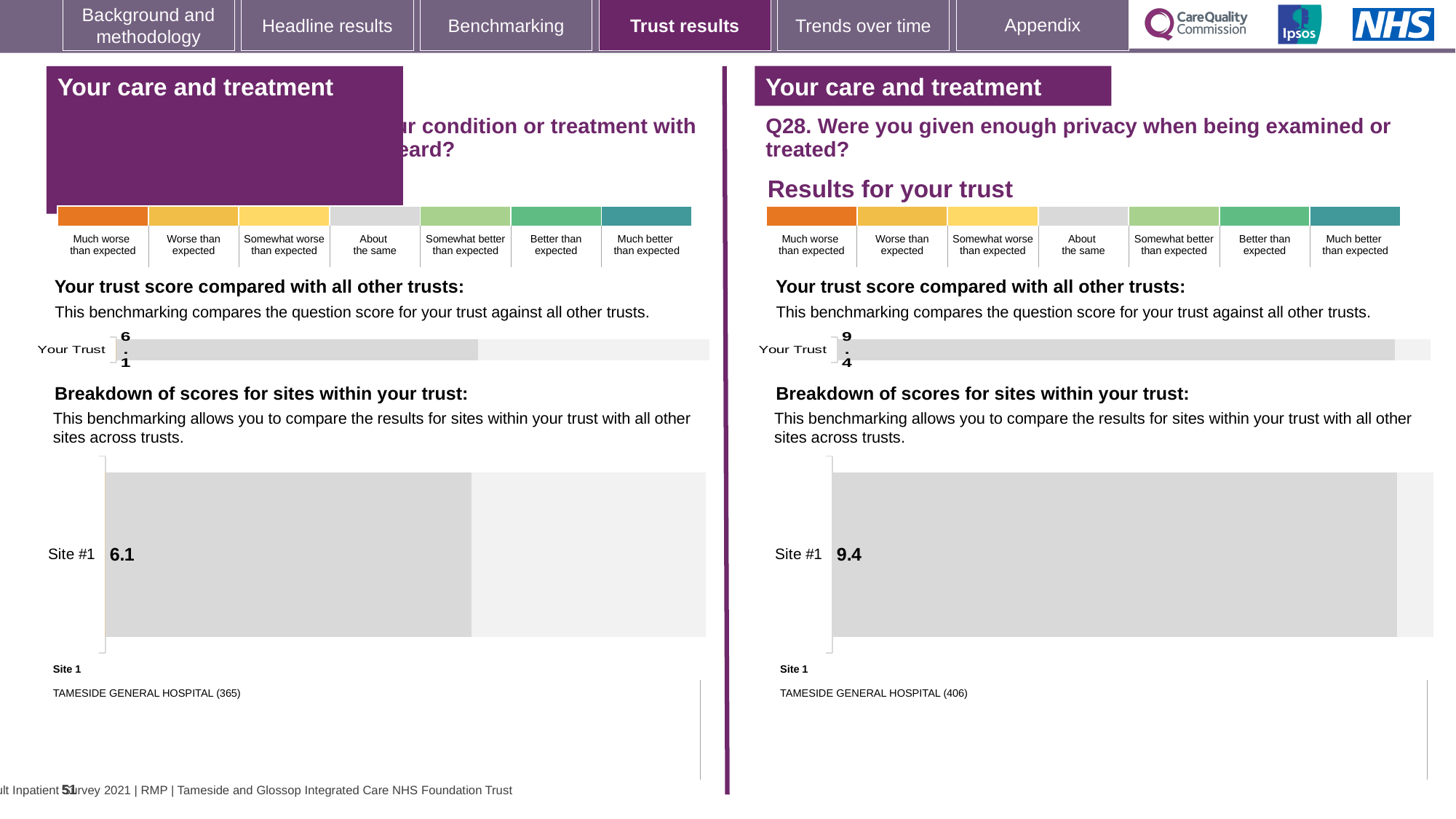
Which is larger: the Your Trust score on the left half of the slide or the Your Trust score on the right half (Q28)? The right half (Q28), 9.4 In the 'Breakdown of scores for sites within your trust' chart on the left half of the slide, what is the value for Site #1? 6.1 On the right half of the slide (Q28, privacy when being examined or treated), what is the score shown for Your Trust? 9.4 What type of chart is used to show the Site #1 score on the right half of the slide (Q28)? Bar chart On the left half of the slide, what is the score shown for Your Trust? 6.1 How many sites are shown in the 'Breakdown of scores for sites within your trust' chart on the left half of the slide? 1 Which site is listed as Site 1 on the left half of the slide? TAMESIDE GENERAL HOSPITAL (365) What type of chart is used to show the Your Trust score on the left half of the slide? Bar chart Which site is listed as Site 1 on the right half of the slide (Q28)? TAMESIDE GENERAL HOSPITAL (406) How many sites are shown in the 'Breakdown of scores for sites within your trust' chart on the right half of the slide (Q28)? 1 In the 'Breakdown of scores for sites within your trust' chart on the right half of the slide (Q28), what is the value for Site #1? 9.4 What is the difference between the Site #1 score on the right half of the slide (Q28) and the Site #1 score on the left half? 3.3